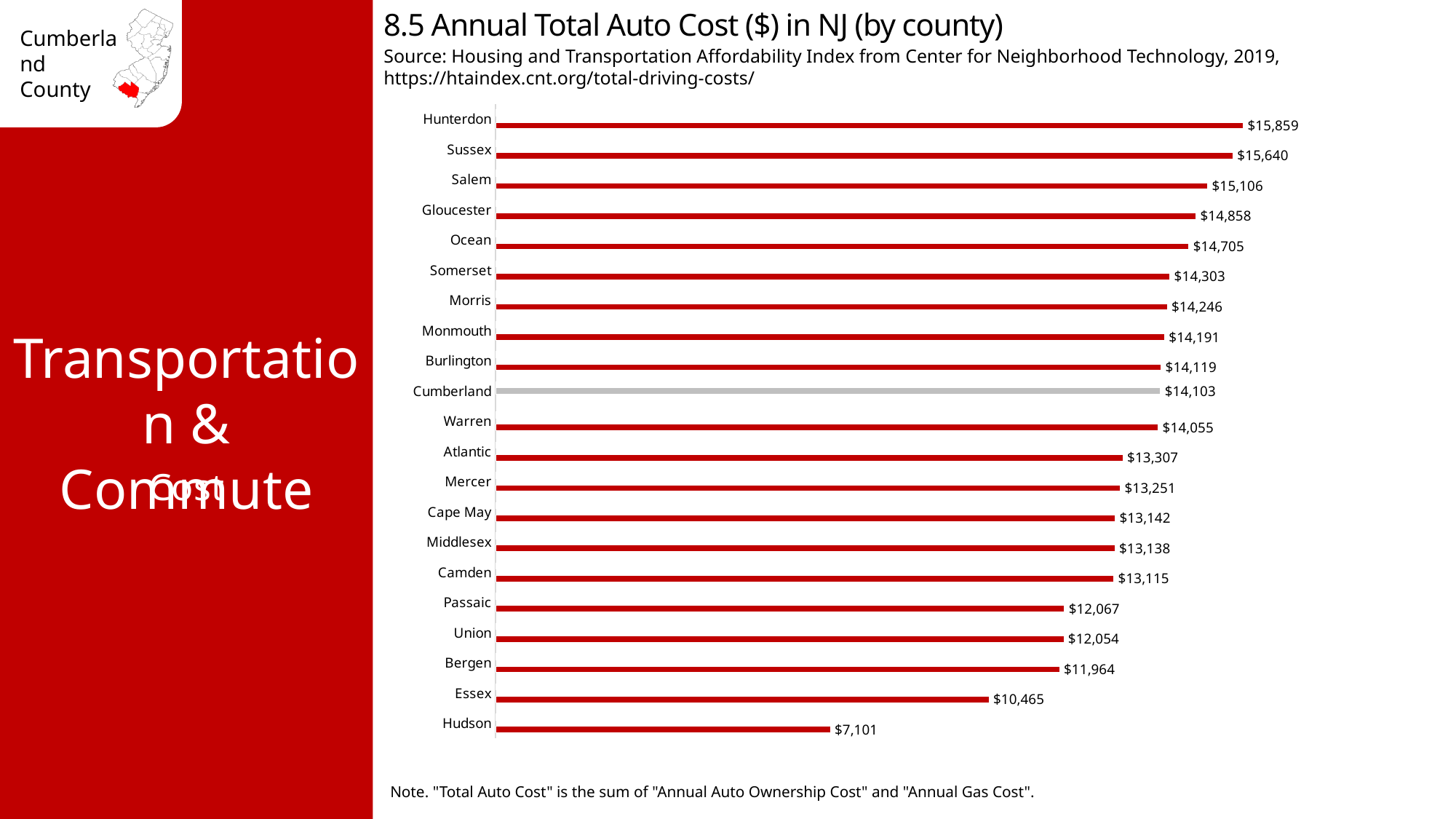
What kind of chart is used to show annual total auto cost by county? Bar chart Which county has the lowest annual total auto cost? Hudson What is the annual total auto cost for Gloucester county? $14,858 What is the difference in annual total auto cost between Hunterdon and Hudson counties? $8,758 Which county has a higher annual total auto cost, Salem or Ocean? Salem What is the difference in annual total auto cost between Hunterdon and Cumberland counties? $1,756 What is the annual total auto cost for Hudson county? $7,101 Which county has the highest annual total auto cost? Hunterdon How many counties are shown in the chart? 21 Which county's bar is shown in a different colour (grey) from the others? Cumberland Which county has a higher annual total auto cost, Essex or Bergen? Bergen What is the annual total auto cost for Cumberland county? $14,103